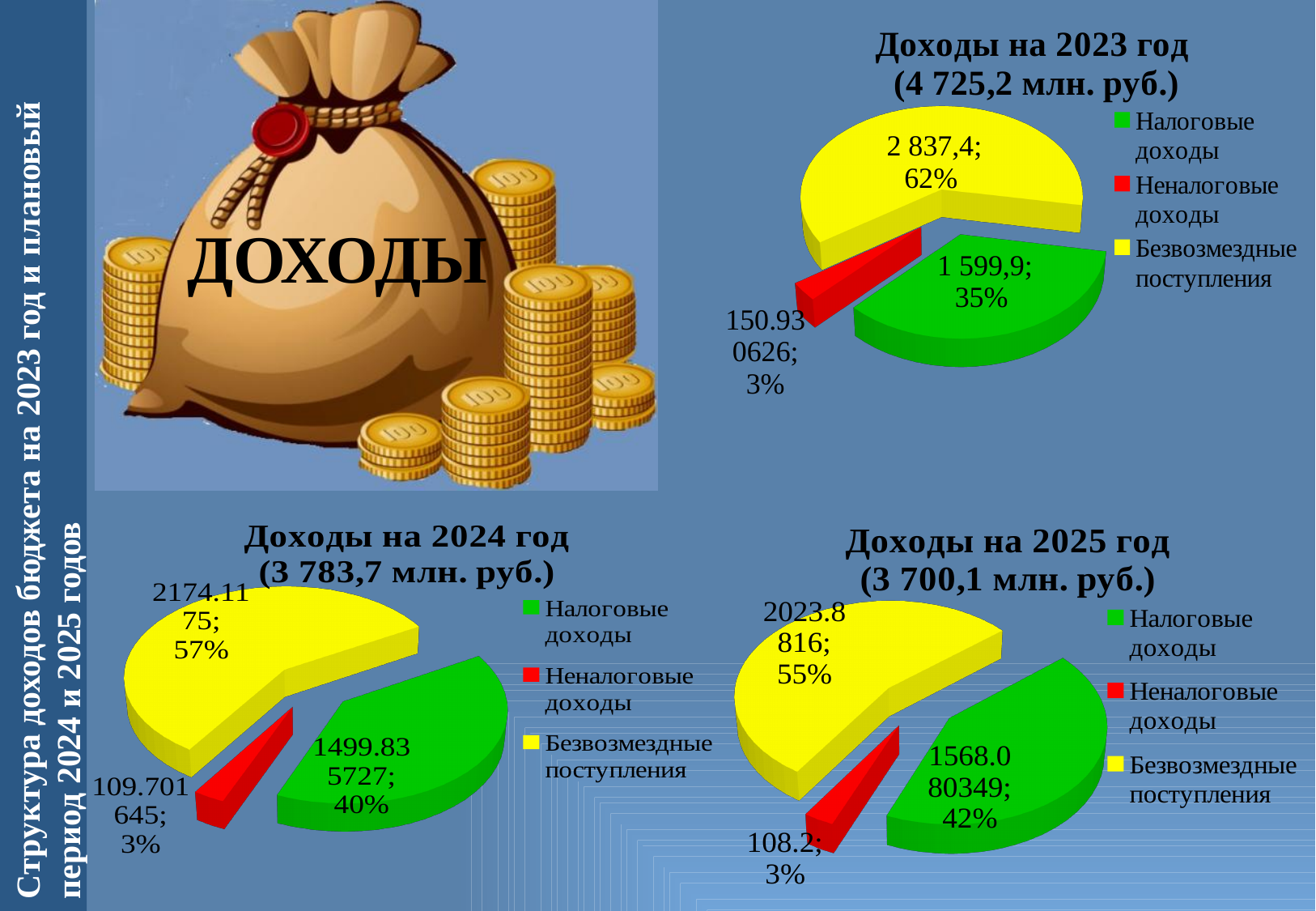
In the 'Доходы на 2023 год' chart, which category has the smallest slice? Неналоговые доходы In the 'Доходы на 2024 год' chart, what is the value for Неналоговые доходы? 109.701645 What type of chart is used for 'Доходы на 2023 год'? pie chart In the 'Доходы на 2025 год' chart, which is larger: Налоговые доходы or Безвозмездные поступления? Безвозмездные поступления In the 'Доходы на 2025 год' chart, what is the value for Неналоговые доходы? 108.2 In the 'Доходы на 2023 год' chart, what share do Безвозмездные поступления have? 62% How many entries does the legend of the 'Доходы на 2024 год' chart list? 3 In the 'Доходы на 2023 год' chart, what is the value for Налоговые доходы? 1 599,9 In the 'Доходы на 2024 год' chart, which category has the largest slice? Безвозмездные поступления What colour represents Неналоговые доходы in the 'Доходы на 2025 год' chart? red In the 'Доходы на 2025 год' chart, what share do Безвозмездные поступления have? 55% In the 'Доходы на 2024 год' chart, what share do Налоговые доходы have? 40%